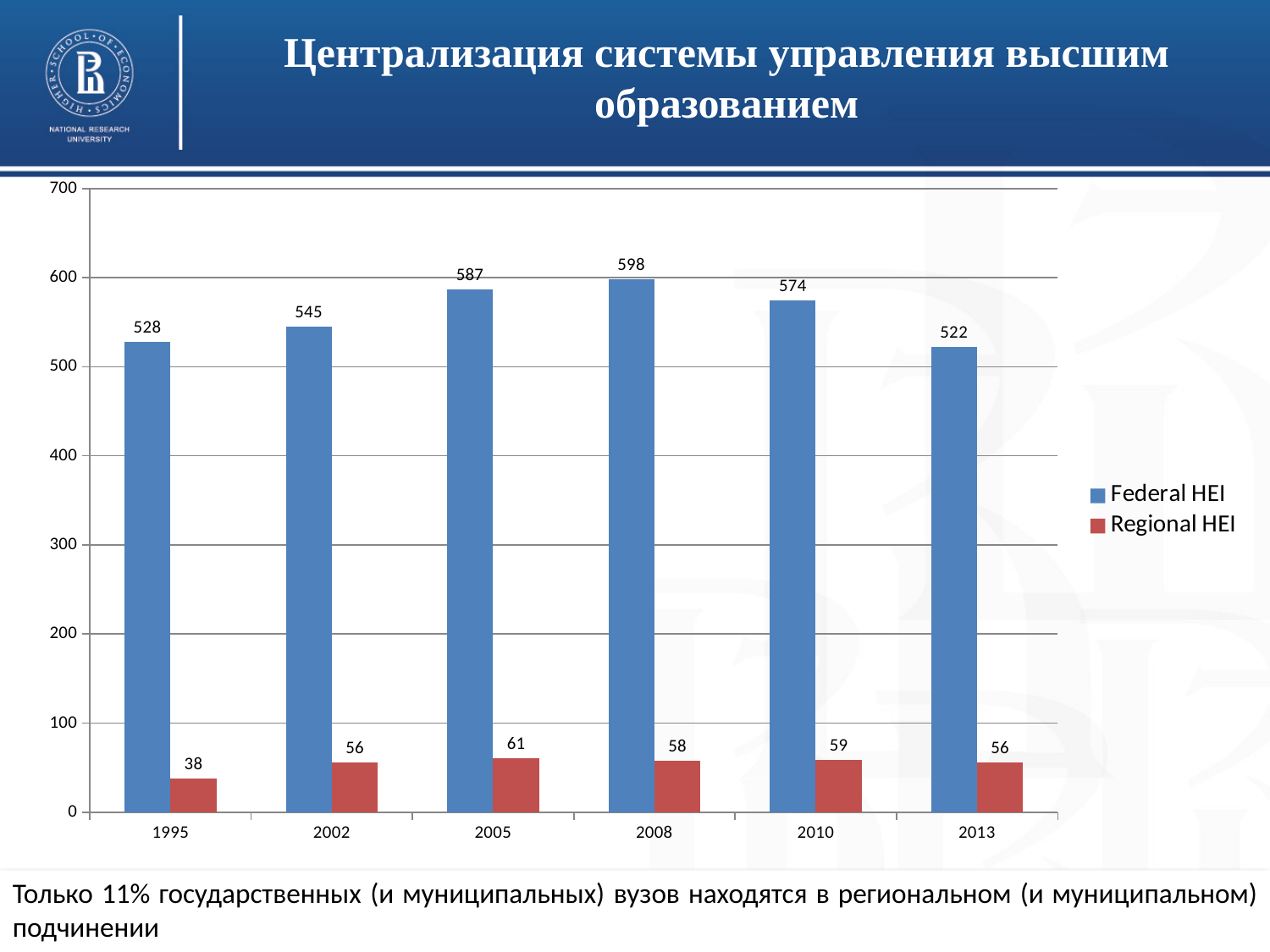
What is the value for Federal HEI in 2008? 598 What is the value for Federal HEI in 2013? 522 Which is larger: the Regional HEI value in 2005 or in 2010? 2005 How many series does the legend list? 2 What kind of chart is shown on the slide? bar chart What is the difference between the Federal HEI values in 2008 and 2013? 76 What is the value for Regional HEI in 1995? 38 In which year is the Regional HEI value lowest? 1995 In which year is the Federal HEI value highest? 2008 Is the Federal HEI value for 2002 greater or less than 500? greater What is the total of Federal HEI and Regional HEI in 2010? 633 How many years are shown on the x axis? 6